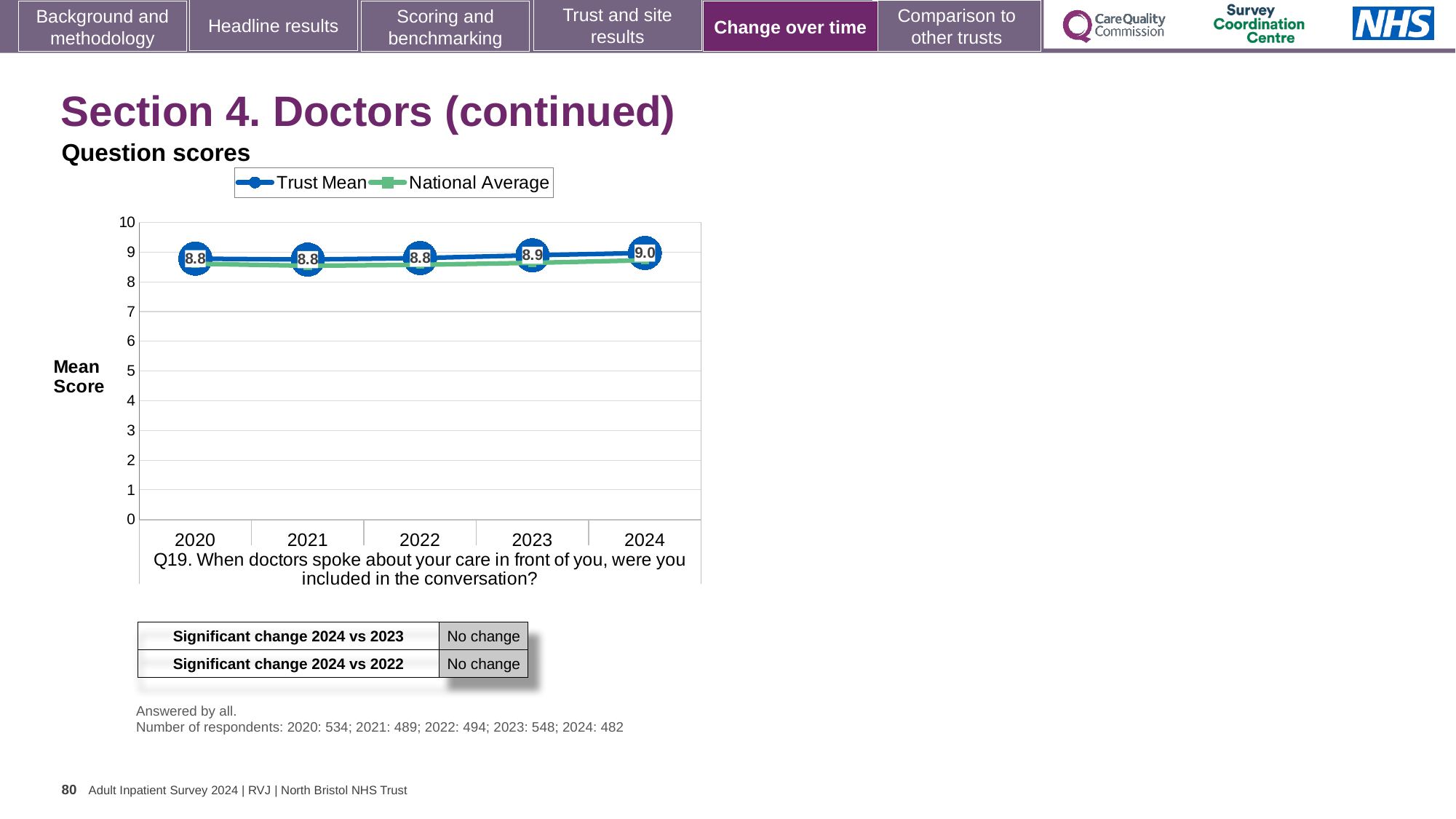
In which year is the Trust Mean score highest? 2024 What are the two series named in the legend? Trust Mean and National Average Is the National Average value for 2021 greater or less than 5? greater How many series does the legend list? 2 What is the Trust Mean score for 2020? 8.8 How many years are plotted on the x axis? 5 What is the difference between the Trust Mean score in 2024 and in 2020? 0.2 What is the Trust Mean score for 2023? 8.9 Does the Trust Mean score rise or fall from 2020 to 2024? rise Which is larger, the Trust Mean score for 2024 or for 2023? 2024 What is the Trust Mean score for 2024? 9.0 What kind of chart is shown on the slide? line chart